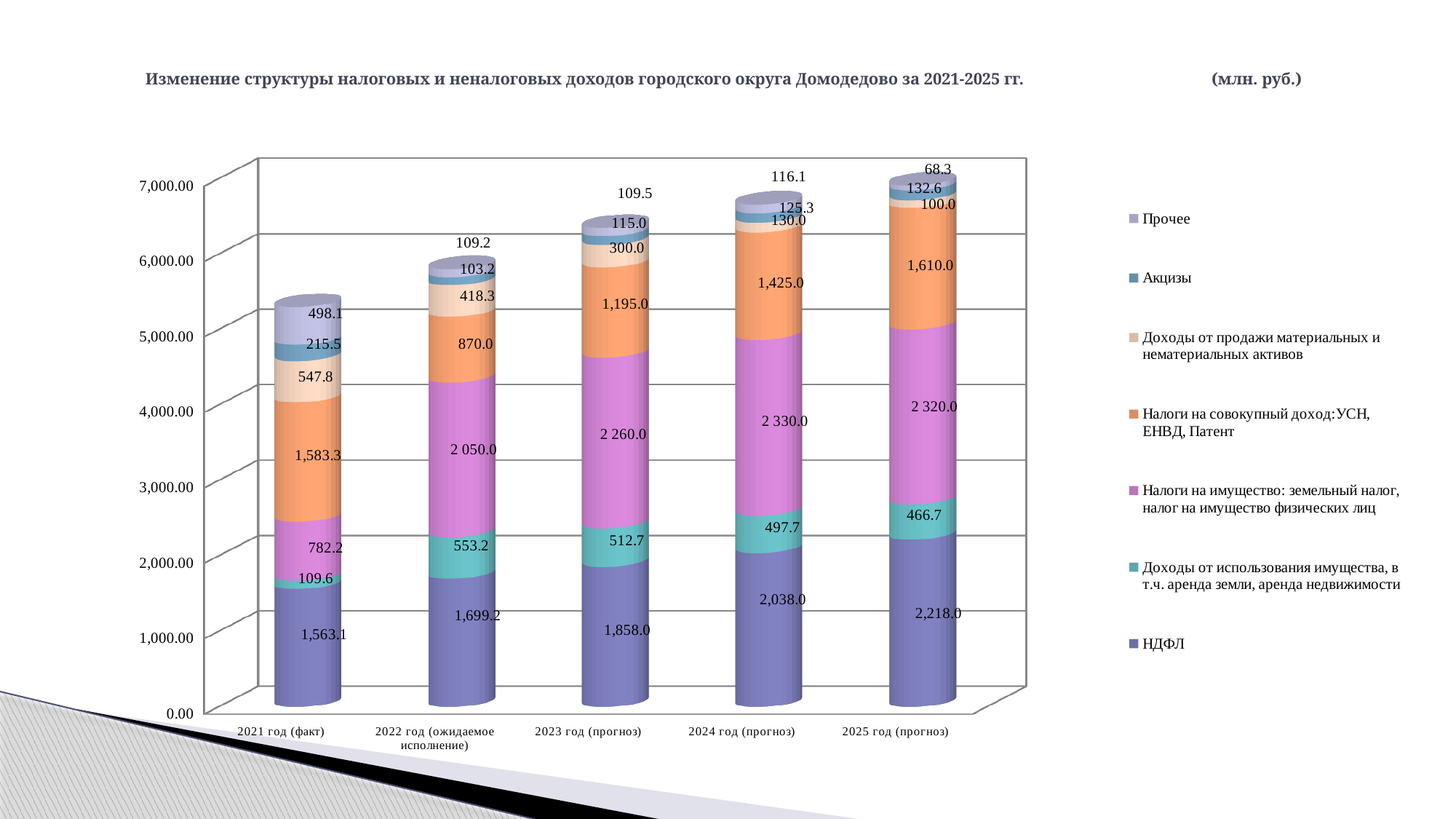
What is the value of Налоги на совокупный доход: УСН, ЕНВД, Патент for 2024 год (прогноз)? 1,425.0 What is the value of НДФЛ for 2021 год (факт)? 1,563.1 In which year is the Прочее value the lowest? 2025 год (прогноз) How many year categories are shown on the x axis? 5 What kind of chart is shown on the slide? Stacked bar chart What is the value of Доходы от продажи материальных и нематериальных активов for 2022 год (ожидаемое исполнение)? 418.3 In which year is the НДФЛ value the highest? 2025 год (прогноз) What is the difference between the НДФЛ values for 2025 год (прогноз) and 2021 год (факт)? 654.9 Which is larger: Налоги на имущество for 2024 год (прогноз) or for 2025 год (прогноз)? 2024 год (прогноз) What is the value of Акцизы for 2025 год (прогноз)? 132.6 How many series does the legend list? 7 Does the НДФЛ value rise or fall from 2021 to 2025? Rises